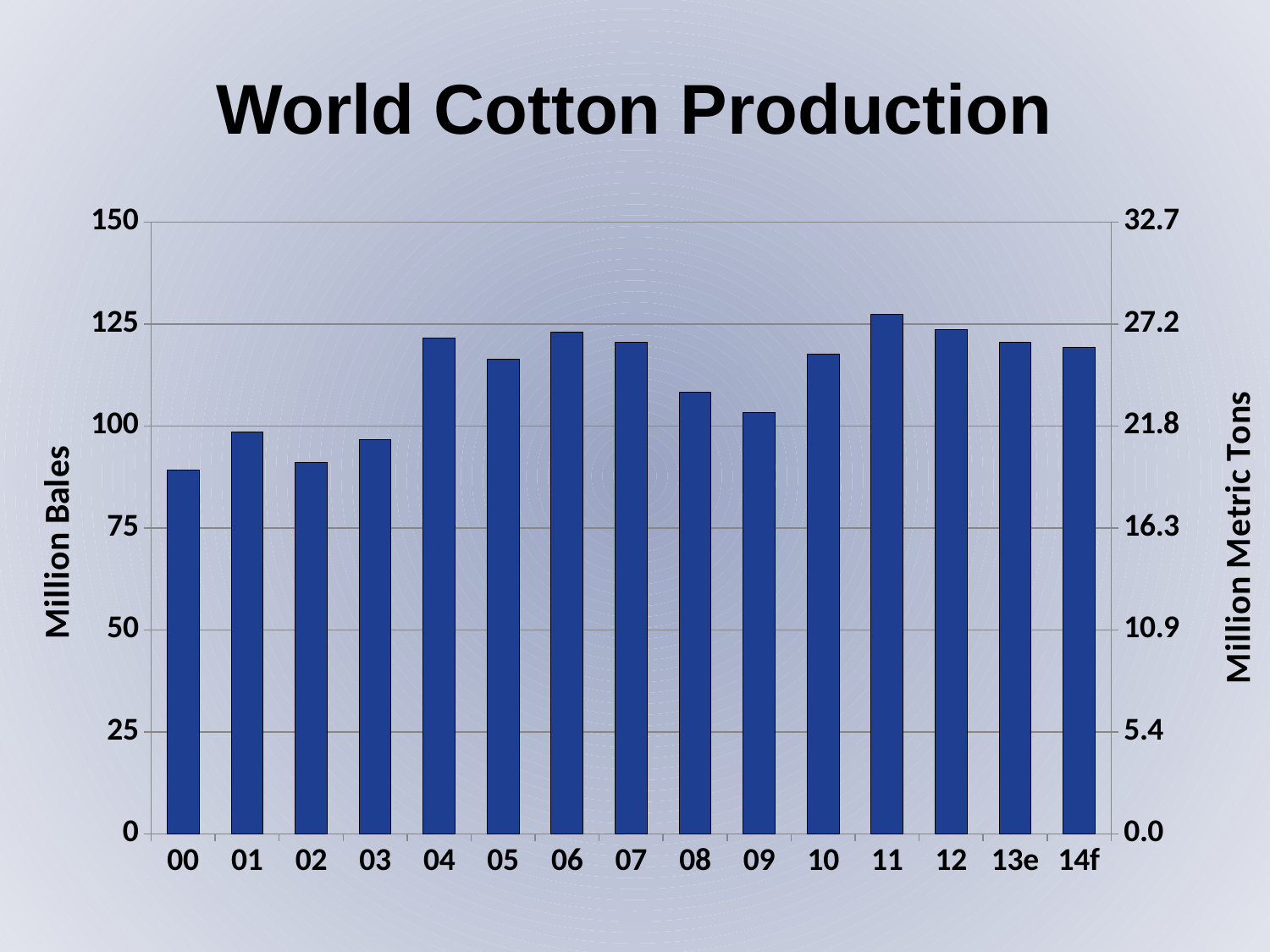
Is the value for 02 greater or less than 100 million bales? less Which year has the larger production, 06 or 09? 06 Is the value for 11 greater or less than 125 million bales? greater What type of chart is shown on the slide? bar chart How many years (bars) are shown on the x axis? 15 Which year has the larger production, 04 or 00? 04 What is the title of the chart? World Cotton Production Is production in 14f higher or lower than in 00? higher Is the value for 00 greater or less than 100 million bales? less What is the label of the left vertical axis? Million Bales Which year has the highest cotton production? 11